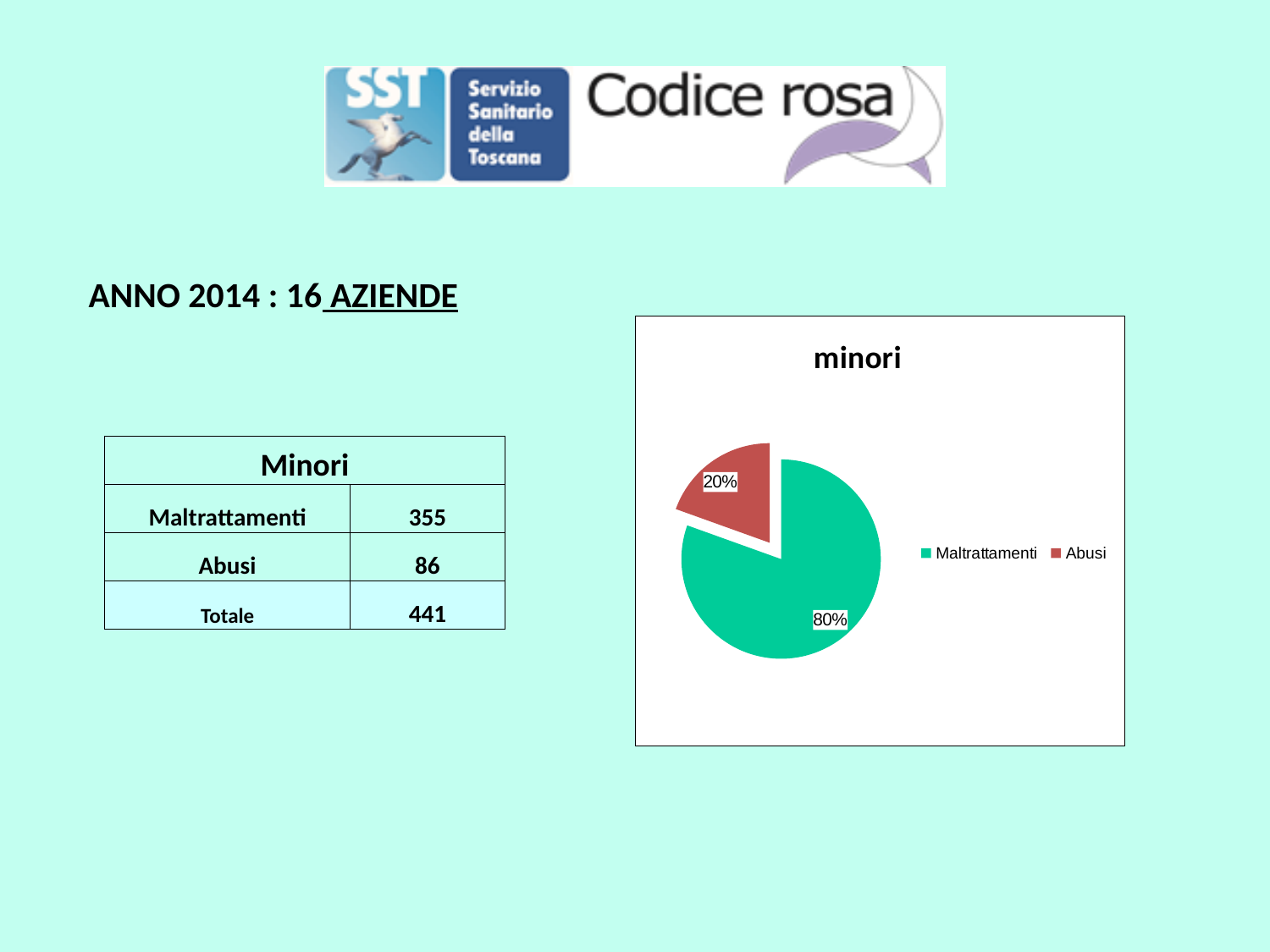
What is the difference in percentage points between the Maltrattamenti and Abusi slices? 60 percentage points What is the title of the pie chart? minori What colour is the Abusi slice in the pie chart? red How many slices does the pie chart have? 2 What share of the pie does Abusi represent? 20% Which slice of the pie chart is the largest? Maltrattamenti How many entries does the legend of the pie chart list? 2 Which slice of the pie chart is the smallest? Abusi What share of the pie does Maltrattamenti represent? 80% What kind of chart is shown on the slide? pie chart Which is larger in the pie chart, Maltrattamenti or Abusi? Maltrattamenti